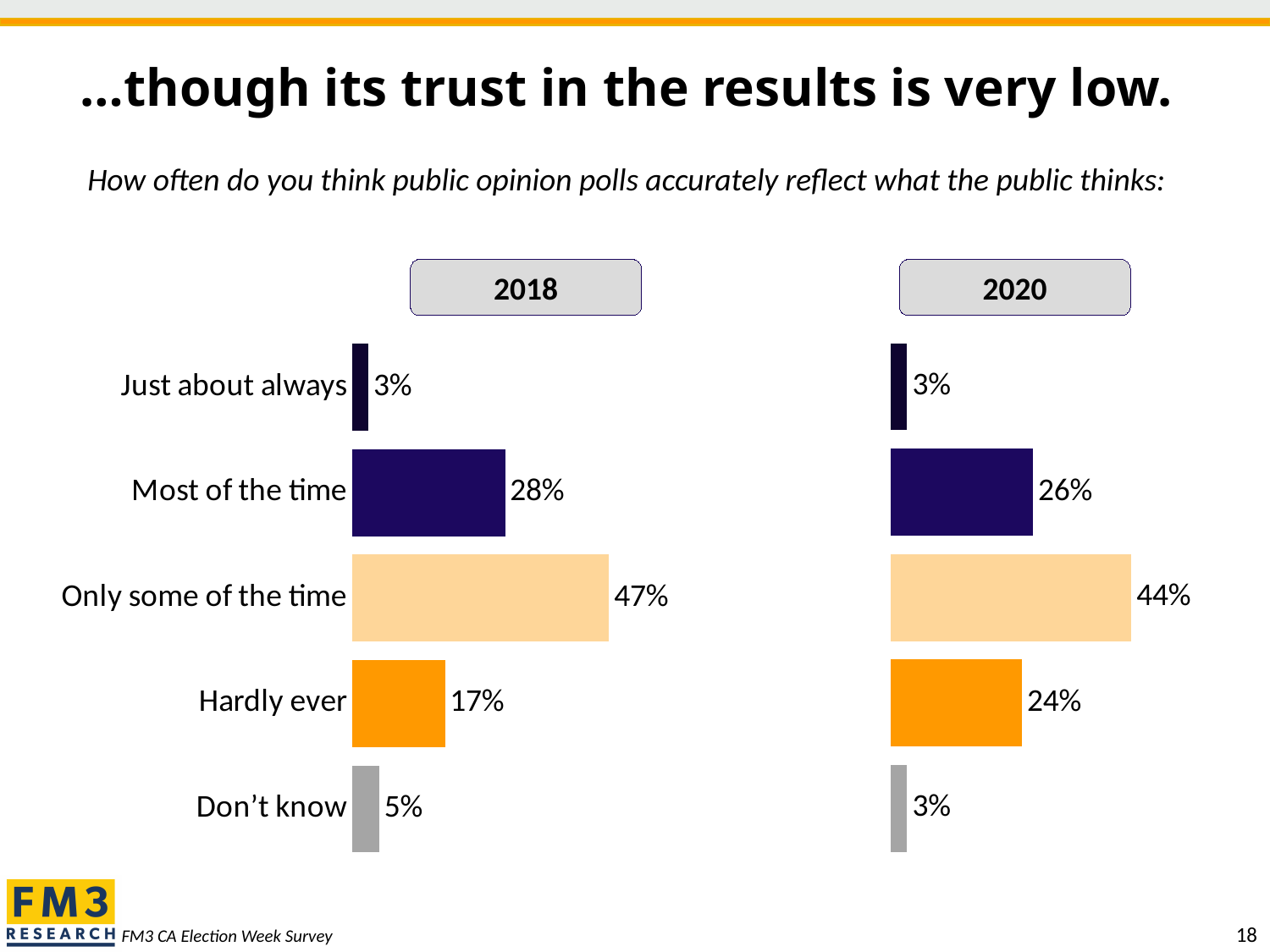
In the 2018 chart, what percentage said "Don't know"? 5% Which is larger: "Most of the time" in the 2018 chart or "Most of the time" in the 2020 chart? 2018 In the 2018 chart, what percentage said "Only some of the time"? 47% What is the difference between the "Hardly ever" percentage in the 2020 chart and in the 2018 chart? 7% In the 2020 chart, what percentage said "Hardly ever"? 24% In the 2020 chart, which response has the highest percentage? Only some of the time In the 2018 chart, which response has the highest percentage? Only some of the time In the 2020 chart, what percentage said "Most of the time"? 26% What is the difference between "Only some of the time" and "Most of the time" in the 2018 chart? 19% What type of chart is used on this slide? Bar chart How many response categories are shown in the 2018 chart? 5 In the 2018 chart, which response has the lowest percentage? Just about always